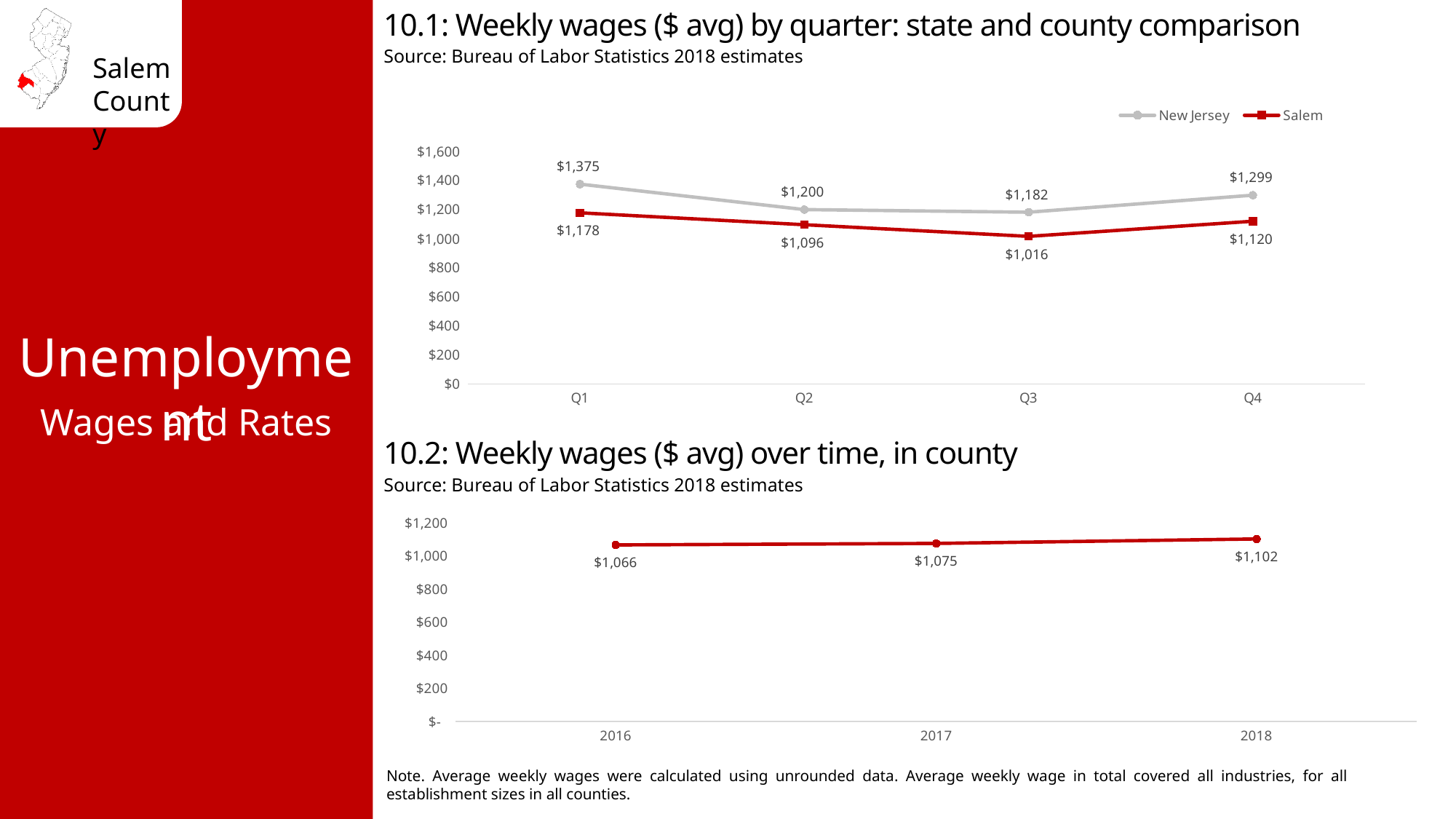
In chart 10.2 (Weekly wages over time, in county), do the values rise or fall from 2016 to 2018? rise In chart 10.1 (Weekly wages by quarter: state and county comparison), which series is drawn in red? Salem In chart 10.1 (Weekly wages by quarter: state and county comparison), what is the difference between the New Jersey and Salem values in Q4? $179 In chart 10.2 (Weekly wages over time, in county), what is the difference between the 2018 and 2016 values? $36 In chart 10.1 (Weekly wages by quarter: state and county comparison), what is the New Jersey value for Q1? $1,375 In chart 10.2 (Weekly wages over time, in county), what is the value for 2017? $1,075 In chart 10.1 (Weekly wages by quarter: state and county comparison), how many series does the legend list? 2 In chart 10.1 (Weekly wages by quarter: state and county comparison), what is the Salem value for Q3? $1,016 In chart 10.2 (Weekly wages over time, in county), how many years are plotted? 3 What kind of chart is chart 10.2 (Weekly wages over time, in county)? line chart In chart 10.1 (Weekly wages by quarter: state and county comparison), which quarter has the highest New Jersey value? Q1 In chart 10.1 (Weekly wages by quarter: state and county comparison), which quarter has the lowest Salem value? Q3